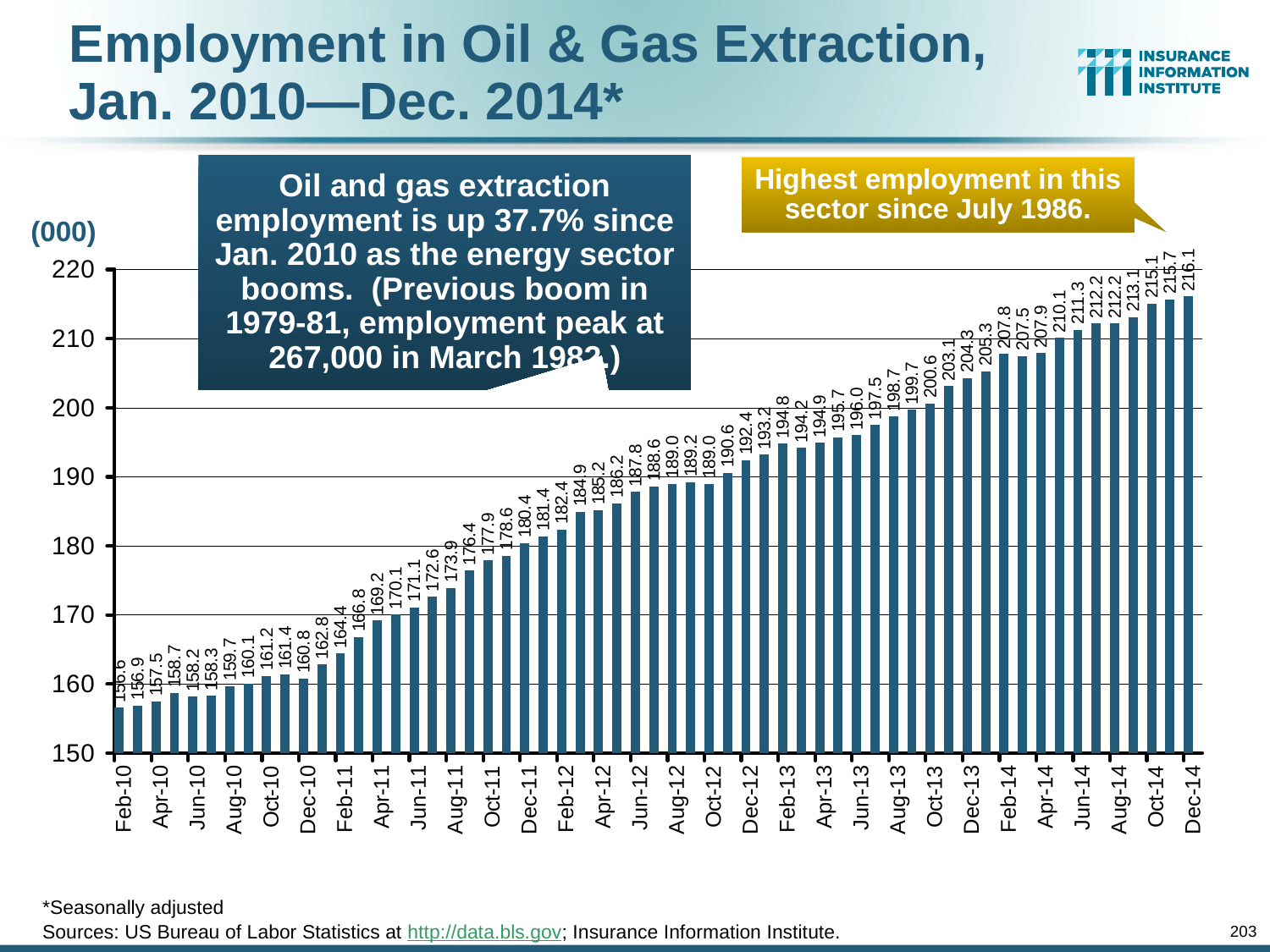
What is the employment value for Dec-14, the last bar on the chart? 216.1 What is the employment value for Feb-10? 156.6 In what units are the values on the y-axis expressed, according to the label above the axis? (000) Do the employment values generally rise or fall from Feb-10 to Dec-14? Rise Is the value for Feb-10 greater or less than 160? less Is the value for Dec-14 greater or less than 210? greater What kind of chart is shown on the slide? Bar chart According to the callout on the chart, since when has employment in this sector not been this high? July 1986 Which is larger, the value for Feb-10 or the value for Dec-14? Dec-14 Which month has the highest employment value on the chart? Dec-14